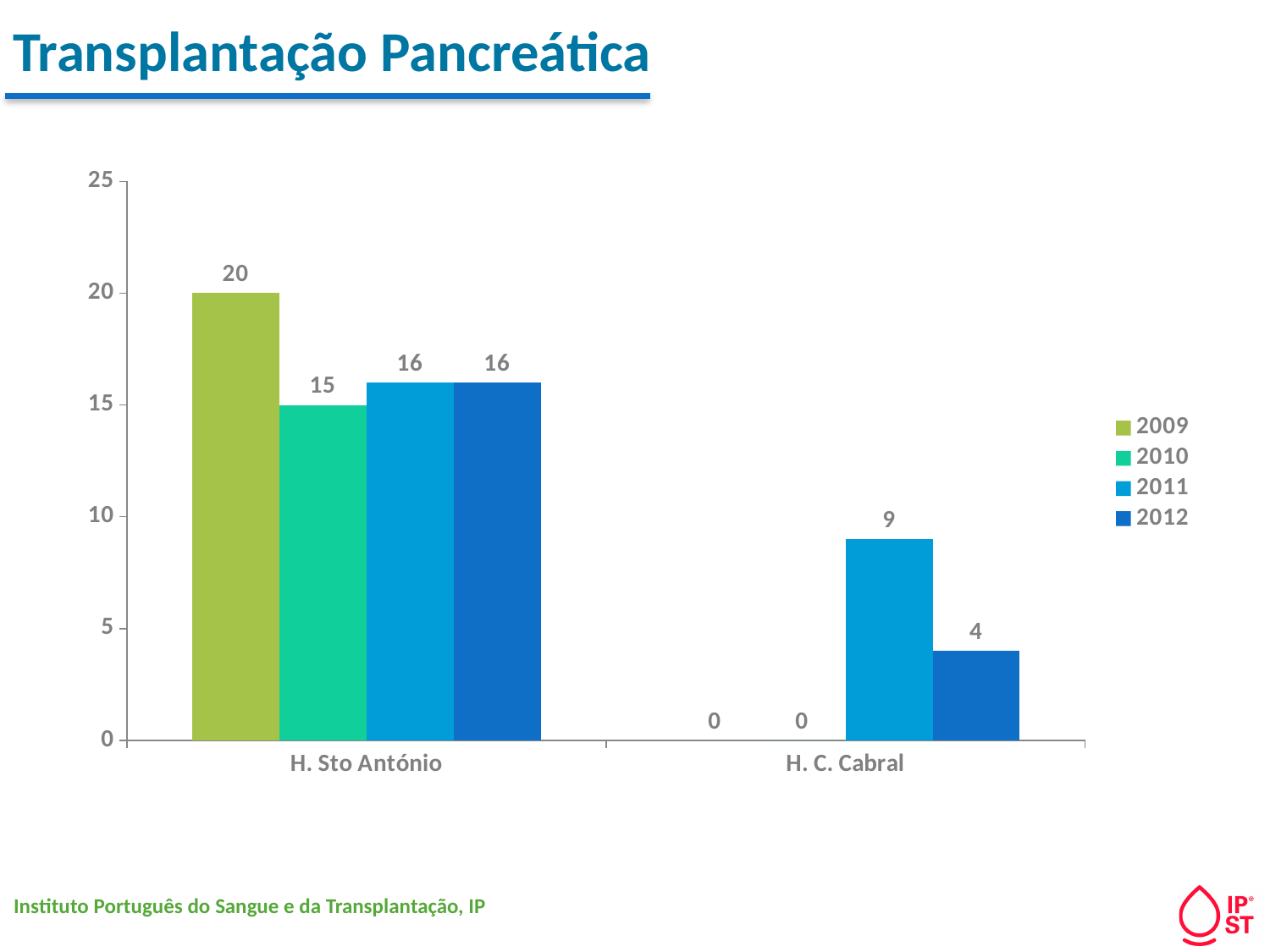
What is the difference between the 2009 and 2010 values for H. Sto António? 5 Which year has the highest value for H. C. Cabral? 2011 How many series does the legend list? 4 Which year has the highest value for H. Sto António? 2009 Which is larger: the 2012 value for H. Sto António or the 2012 value for H. C. Cabral? H. Sto António What is the value for H. Sto António in 2009? 20 What is the difference between the 2011 values for H. Sto António and H. C. Cabral? 7 What is the value for H. Sto António in 2010? 15 How many categories are shown on the x axis? 2 What is the value for H. C. Cabral in 2011? 9 What kind of chart is shown on the slide? Bar chart What is the value for H. C. Cabral in 2012? 4